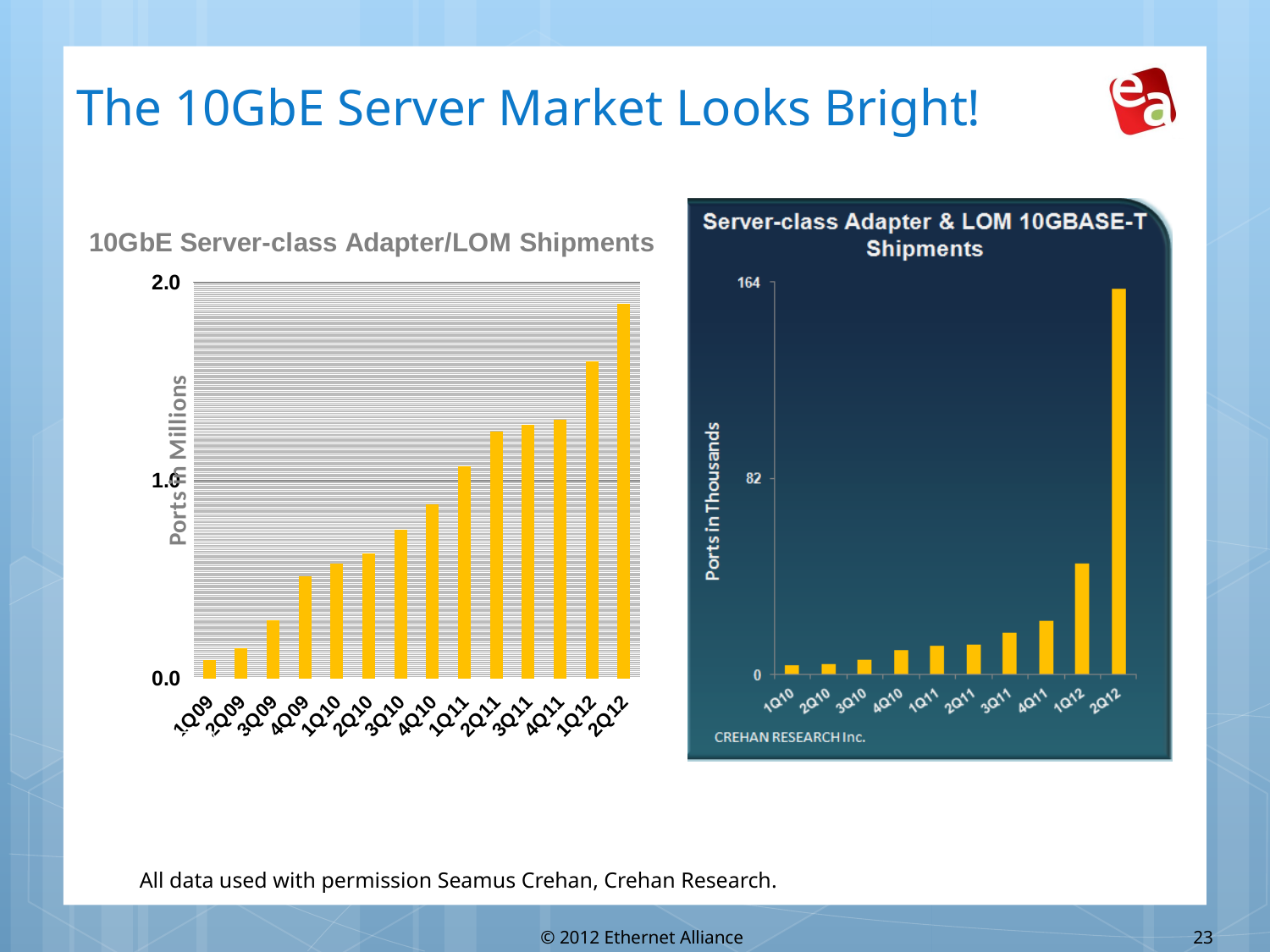
In the 'Server-class Adapter & LOM 10GBASE-T Shipments' chart on the right, which is larger, the value for 4Q11 or the value for 1Q12? 1Q12 In the '10GbE Server-class Adapter/LOM Shipments' chart on the left, do the values generally rise or fall from 1Q09 to 2Q12? rise In the '10GbE Server-class Adapter/LOM Shipments' chart on the left, which quarter has the lowest value? 1Q09 How many quarters are plotted in the 'Server-class Adapter & LOM 10GBASE-T Shipments' chart on the right? 10 What kind of chart is the '10GbE Server-class Adapter/LOM Shipments' chart on the left? bar chart In the 'Server-class Adapter & LOM 10GBASE-T Shipments' chart on the right, is the value for 1Q12 greater or less than 82? less What is the y-axis label of the '10GbE Server-class Adapter/LOM Shipments' chart on the left? Ports in Millions How many quarters are plotted in the '10GbE Server-class Adapter/LOM Shipments' chart on the left? 14 In the '10GbE Server-class Adapter/LOM Shipments' chart on the left, is the value for 2Q12 greater or less than 1.0? greater In the 'Server-class Adapter & LOM 10GBASE-T Shipments' chart on the right, which quarter has the highest value? 2Q12 In the '10GbE Server-class Adapter/LOM Shipments' chart on the left, is the value for 4Q10 greater or less than 1.0? less In the '10GbE Server-class Adapter/LOM Shipments' chart on the left, which quarter has the highest value? 2Q12